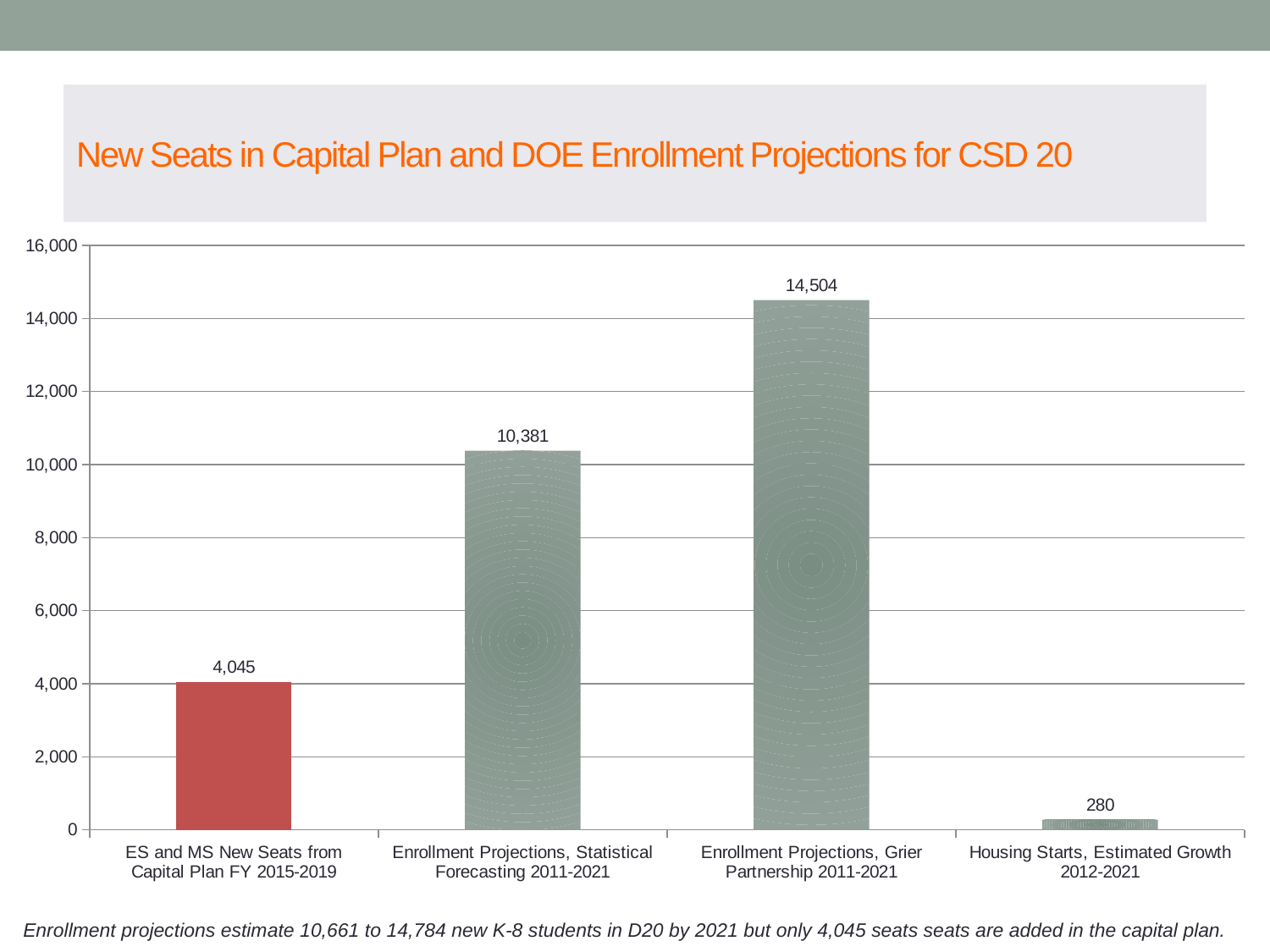
What is the difference between the Statistical Forecasting projection and the ES and MS New Seats from the Capital Plan? 6,336 Which category has the highest value? Enrollment Projections, Grier Partnership 2011-2021 What is the value for ES and MS New Seats from Capital Plan FY 2015-2019? 4,045 What is the value for Enrollment Projections, Statistical Forecasting 2011-2021? 10,381 Which category has the lowest value? Housing Starts, Estimated Growth 2012-2021 How many categories are shown in the chart? 4 What is the difference between the Grier Partnership projection and the Statistical Forecasting projection? 4,123 What kind of chart is shown on the slide? Bar chart What is the value for Enrollment Projections, Grier Partnership 2011-2021? 14,504 Which is larger: ES and MS New Seats from Capital Plan FY 2015-2019 or Housing Starts, Estimated Growth 2012-2021? ES and MS New Seats from Capital Plan FY 2015-2019 What is the title of the chart? New Seats in Capital Plan and DOE Enrollment Projections for CSD 20 What is the value for Housing Starts, Estimated Growth 2012-2021? 280